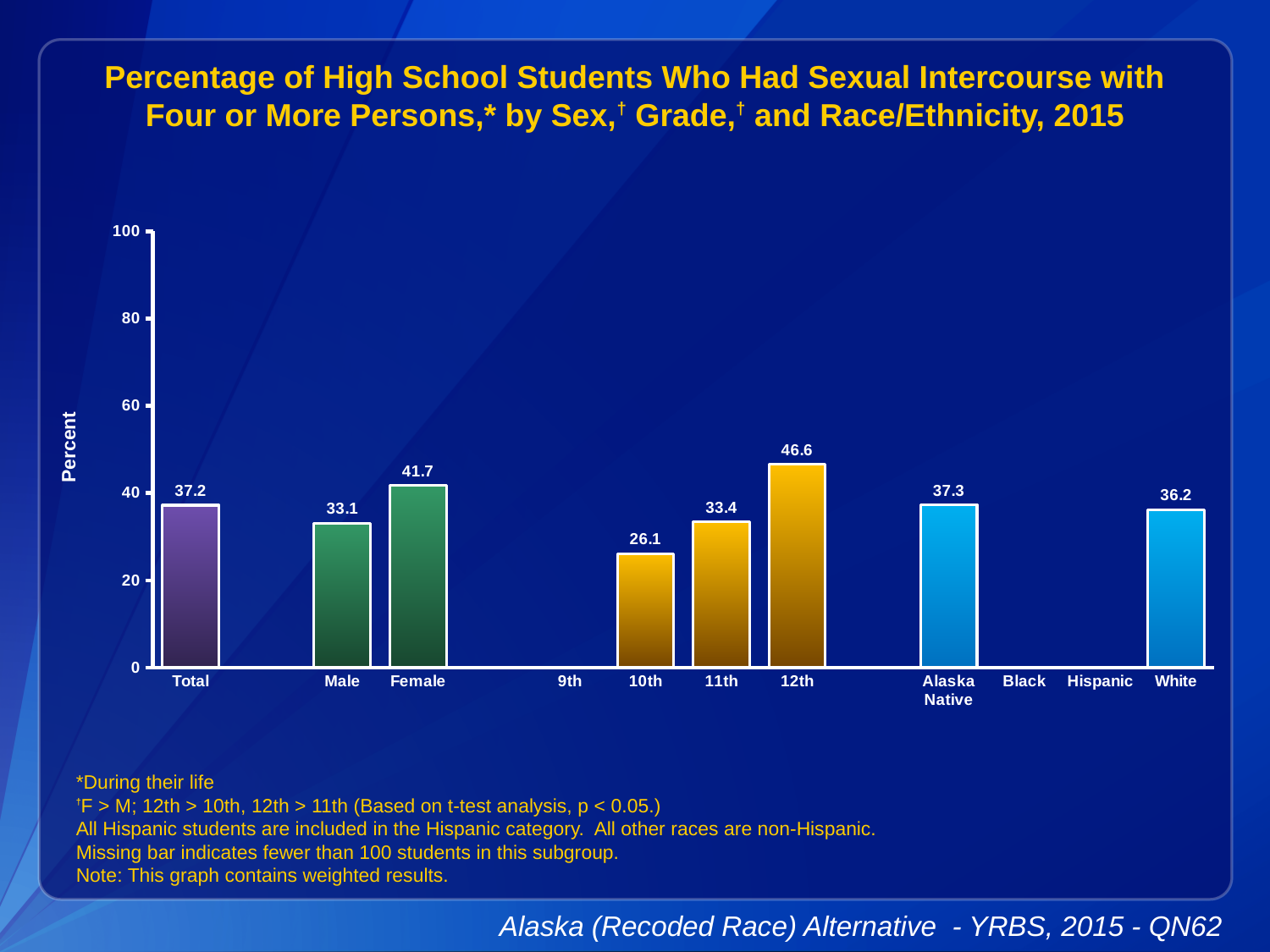
Which category with a bar has the lowest value? 10th Which category has the highest value? 12th What is the value for Total? 37.2 What is the value for 12th grade? 46.6 How many categories have a bar shown? 8 What is the label on the y axis? Percent What kind of chart is this? bar chart What is the difference between the Female and Male values? 8.6 Is the value for White greater or less than 40? less Which is larger, the value for 11th grade or the value for 10th grade? 11th What is the value for Female? 41.7 What is the value for Alaska Native? 37.3